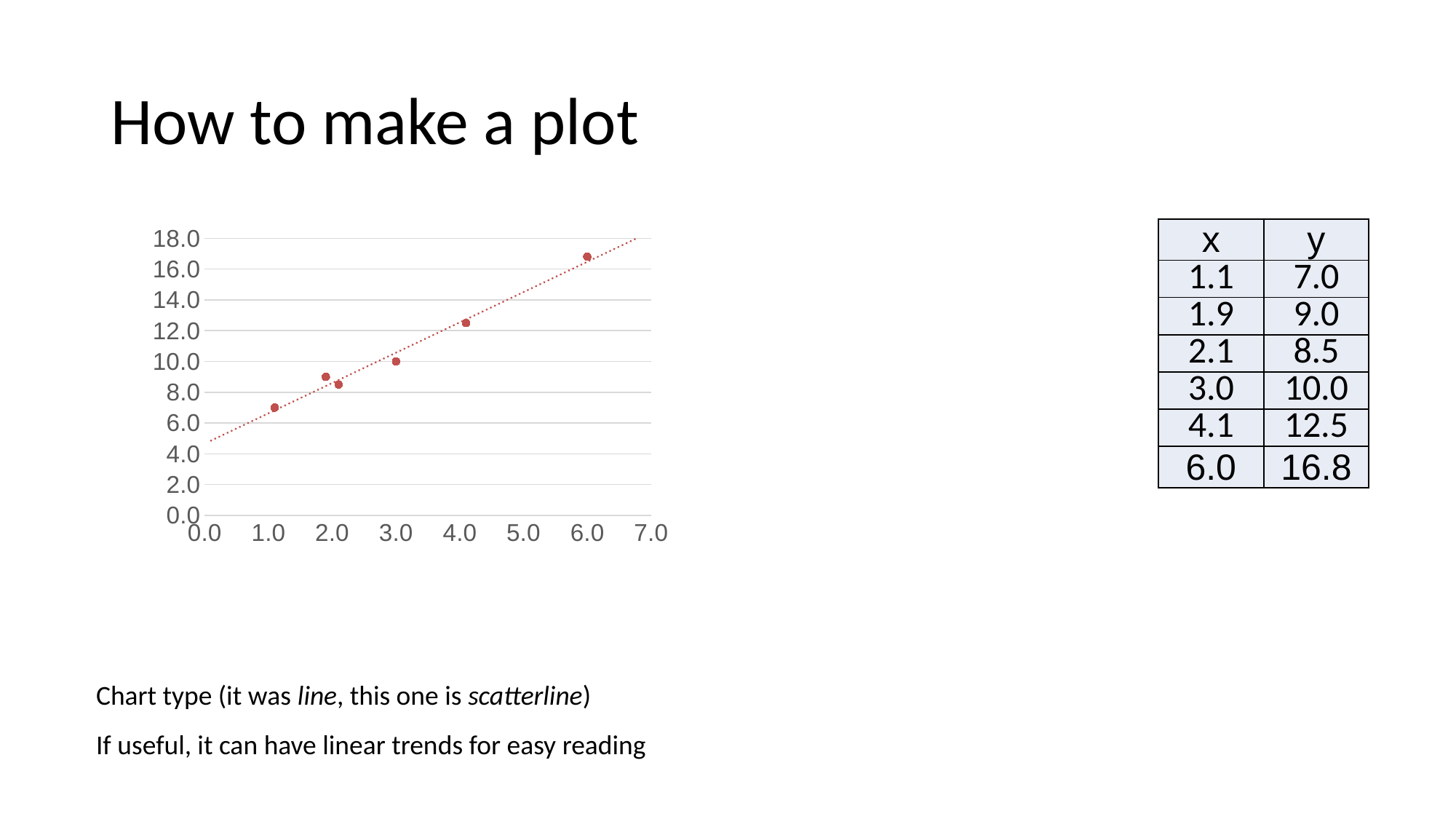
According to the table, what is the y value when x is 1.1? 7.0 What is the maximum value shown on the y axis of the chart? 18.0 How many data points are plotted in the scatter chart? 6 Which x value in the table has the lowest y value? 1.1 According to the table, what is the y value when x is 6.0? 16.8 What is the difference between the y values at x = 6.0 and x = 4.1? 4.3 According to the table, what is the y value when x is 3.0? 10.0 Is the y value of the point at x = 4.1 greater or less than 12.0? greater What kind of chart is shown on the slide? scatter chart Which x value in the table has the highest y value? 6.0 Which has the larger y value: x = 1.9 or x = 2.1? x = 1.9 Do the y values generally rise or fall as x increases along the x axis? rise